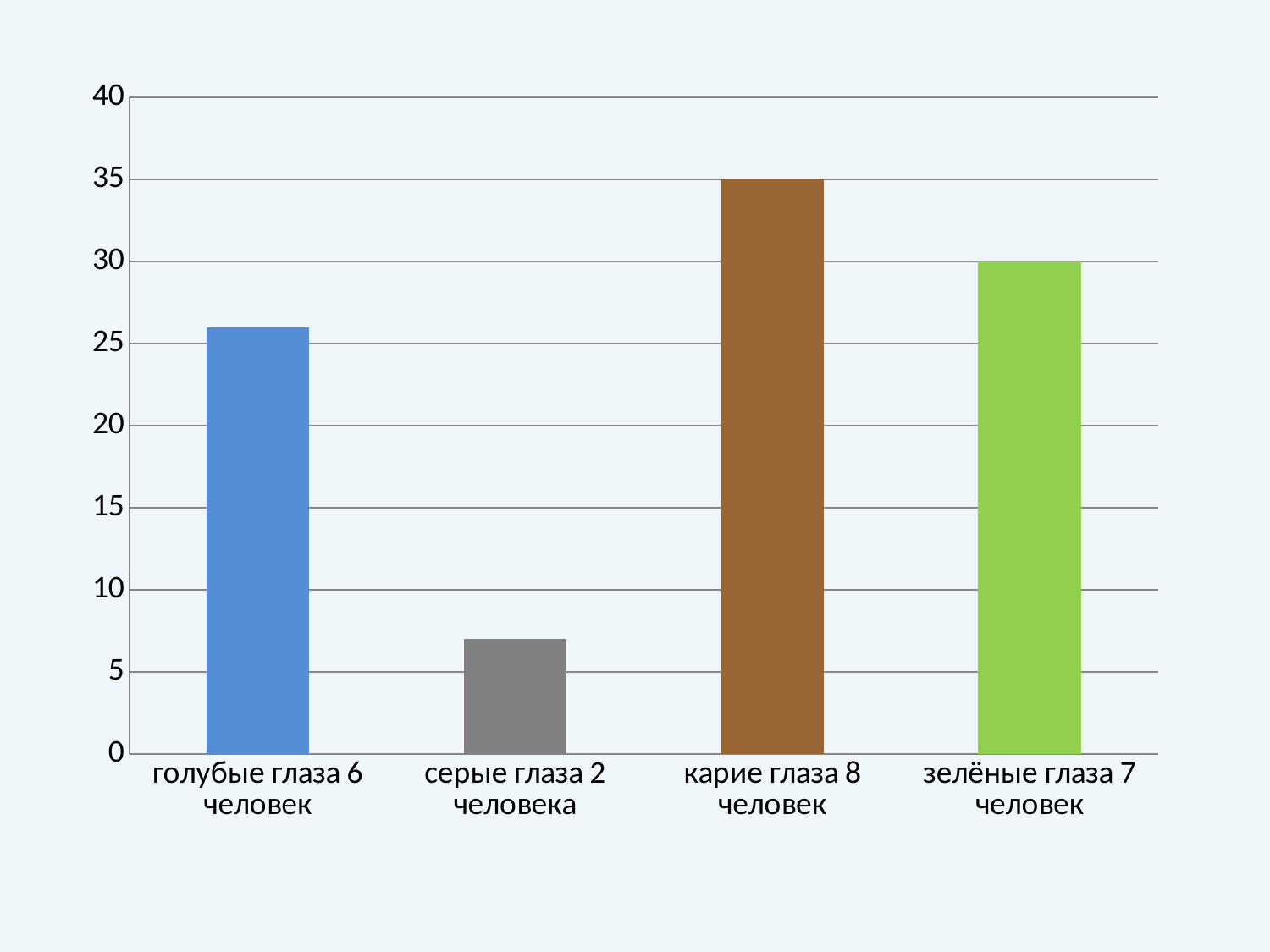
Which is larger, the value for голубые глаза 6 человек or the value for зелёные глаза 7 человек? зелёные глаза 7 человек What is the difference between the values for карие глаза 8 человек and зелёные глаза 7 человек? 5 How many categories are shown on the chart? 4 Which category has the lowest bar? серые глаза 2 человека Is the value for голубые глаза 6 человек greater or less than 25? greater What is the value for зелёные глаза 7 человек? 30 Is the value for голубые глаза 6 человек greater or less than 30? less Is the value for серые глаза 2 человека greater or less than 10? less Which category has the highest bar? карие глаза 8 человек What is the value for карие глаза 8 человек? 35 What kind of chart is shown on the slide? bar chart